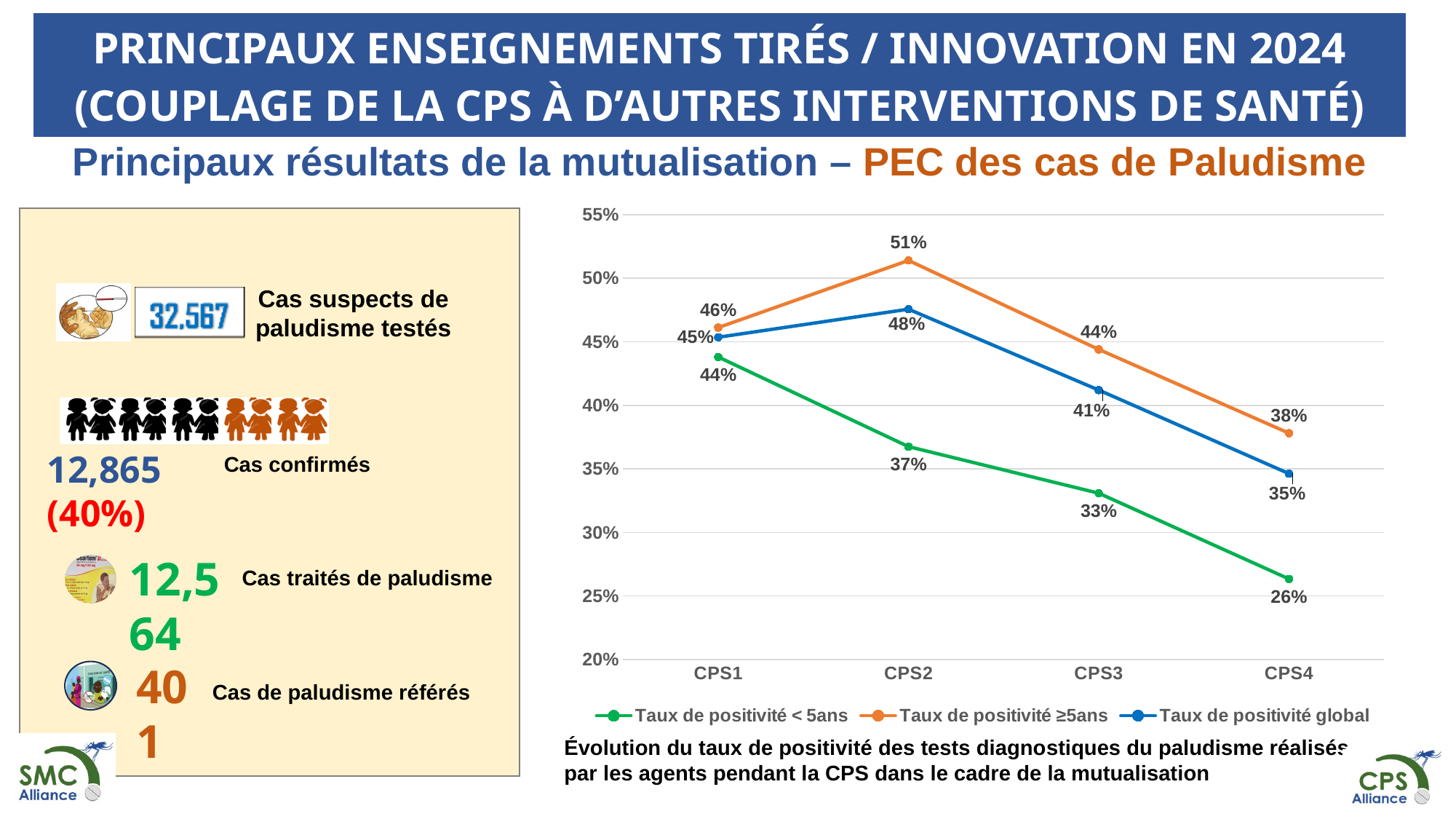
What is the value of 'Taux de positivité global' at CPS3? 41% At which CPS cycle is 'Taux de positivité ≥5ans' highest? CPS2 Which is larger at CPS1: 'Taux de positivité ≥5ans' or 'Taux de positivité < 5ans'? Taux de positivité ≥5ans At which CPS cycle is 'Taux de positivité < 5ans' lowest? CPS4 What is the value of 'Taux de positivité < 5ans' at CPS4? 26% What is the difference between 'Taux de positivité ≥5ans' and 'Taux de positivité < 5ans' at CPS4? 12% How many series does the chart legend list? 3 Which colour is used for the 'Taux de positivité global' line? Blue What is the value of 'Taux de positivité ≥5ans' at CPS2? 51% How many CPS cycles are shown on the x axis of the chart? 4 Does 'Taux de positivité < 5ans' rise or fall from CPS1 to CPS4? Fall What kind of chart is shown on the slide? Line chart